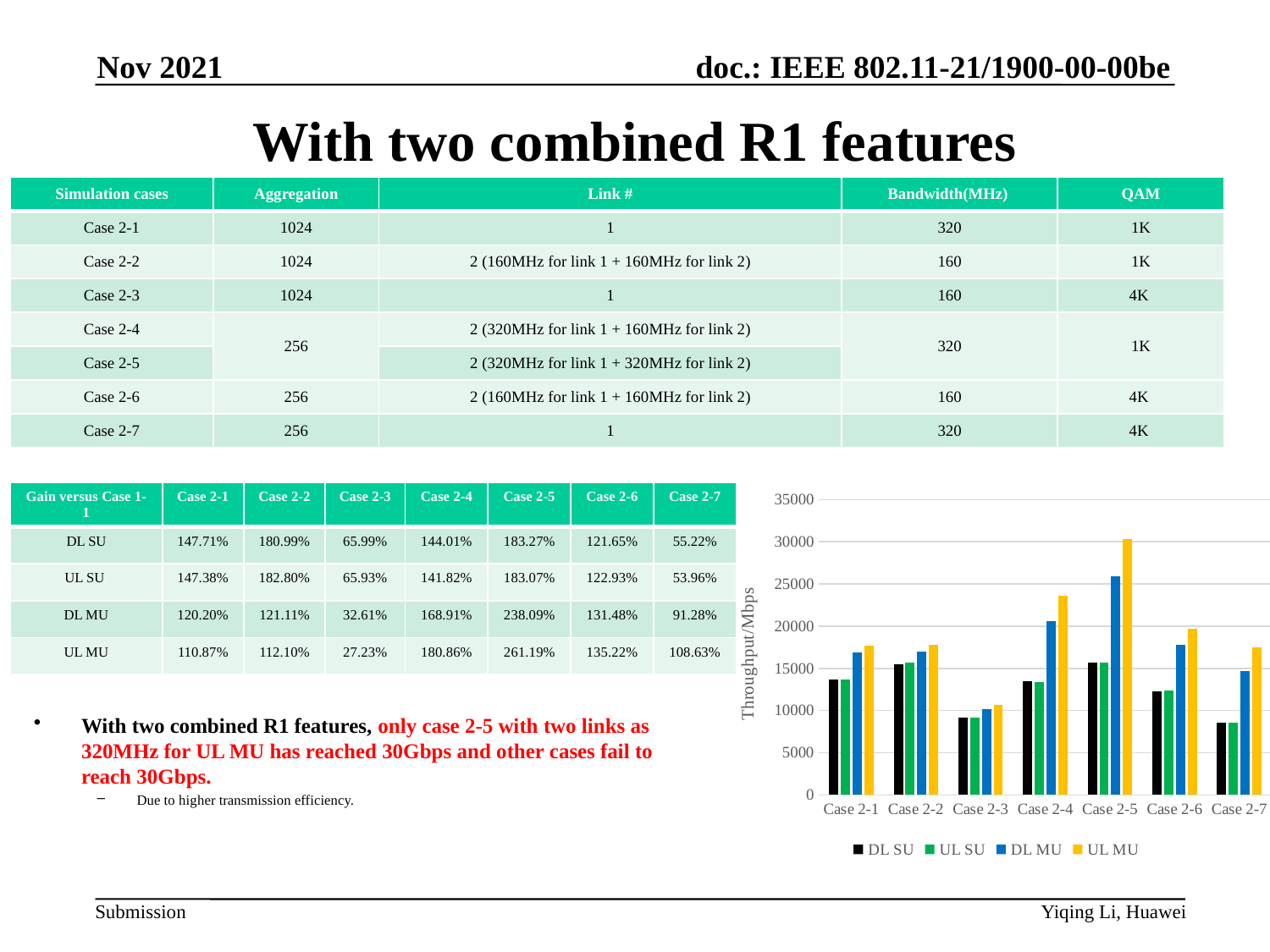
Which is larger: the UL MU value for Case 2-4 or the UL MU value for Case 2-5? Case 2-5 Which case has the lowest UL MU throughput in the chart? Case 2-3 For Case 2-4, which is larger: the DL MU value or the UL MU value? UL MU How many simulation cases are plotted along the x axis of the chart? 7 Which colour represents the UL MU series in the chart? yellow What kind of chart is shown on the slide? bar chart Is the DL MU value for Case 2-7 greater or less than 10000? greater Is the DL SU value for Case 2-3 greater or less than 10000? less Is the UL MU value for Case 2-5 greater or less than 25000? greater What is the label on the y axis of the chart? Throughput/Mbps Which case has the highest UL MU throughput in the chart? Case 2-5 How many series does the chart legend list? 4